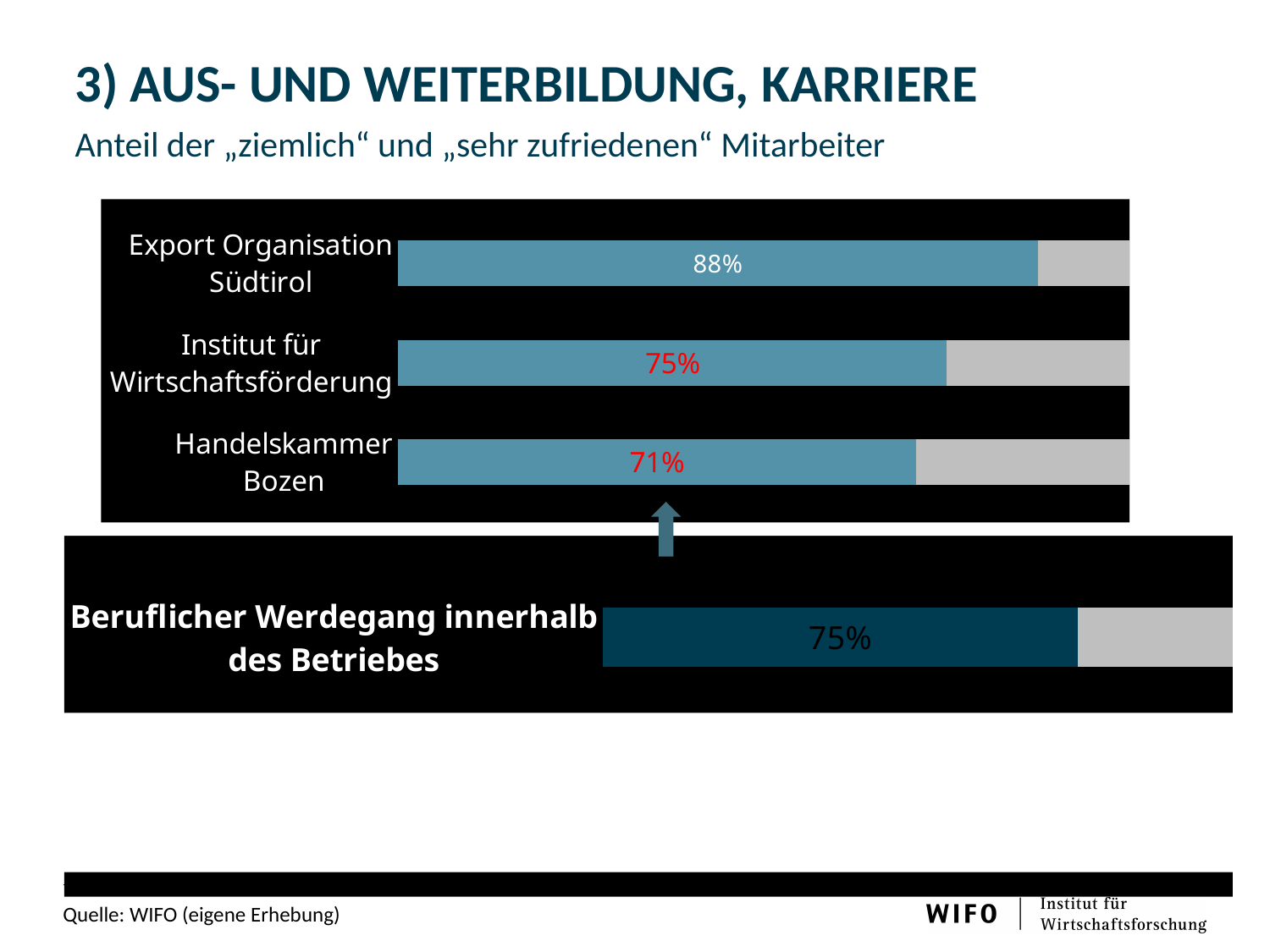
How many categories does the upper chart show? 3 In the upper chart, what is the value for Export Organisation Südtirol? 88% In the upper chart, which is larger: the value for Export Organisation Südtirol or the value for Institut für Wirtschaftsförderung? Export Organisation Südtirol In the upper chart, what is the difference between the values for Export Organisation Südtirol and Handelskammer Bozen? 17% In the upper chart, what is the value for Institut für Wirtschaftsförderung? 75% In the upper chart, which category has the lowest value? Handelskammer Bozen In the upper chart, what is the difference between the values for Institut für Wirtschaftsförderung and Handelskammer Bozen? 4% In the upper chart, which category has the highest value? Export Organisation Südtirol What kind of chart is the upper chart? Bar chart In the upper chart, what is the value for Handelskammer Bozen? 71% In the lower chart, what is the value for Beruflicher Werdegang innerhalb des Betriebes? 75% In the upper chart, which values are printed in red? 75% and 71%